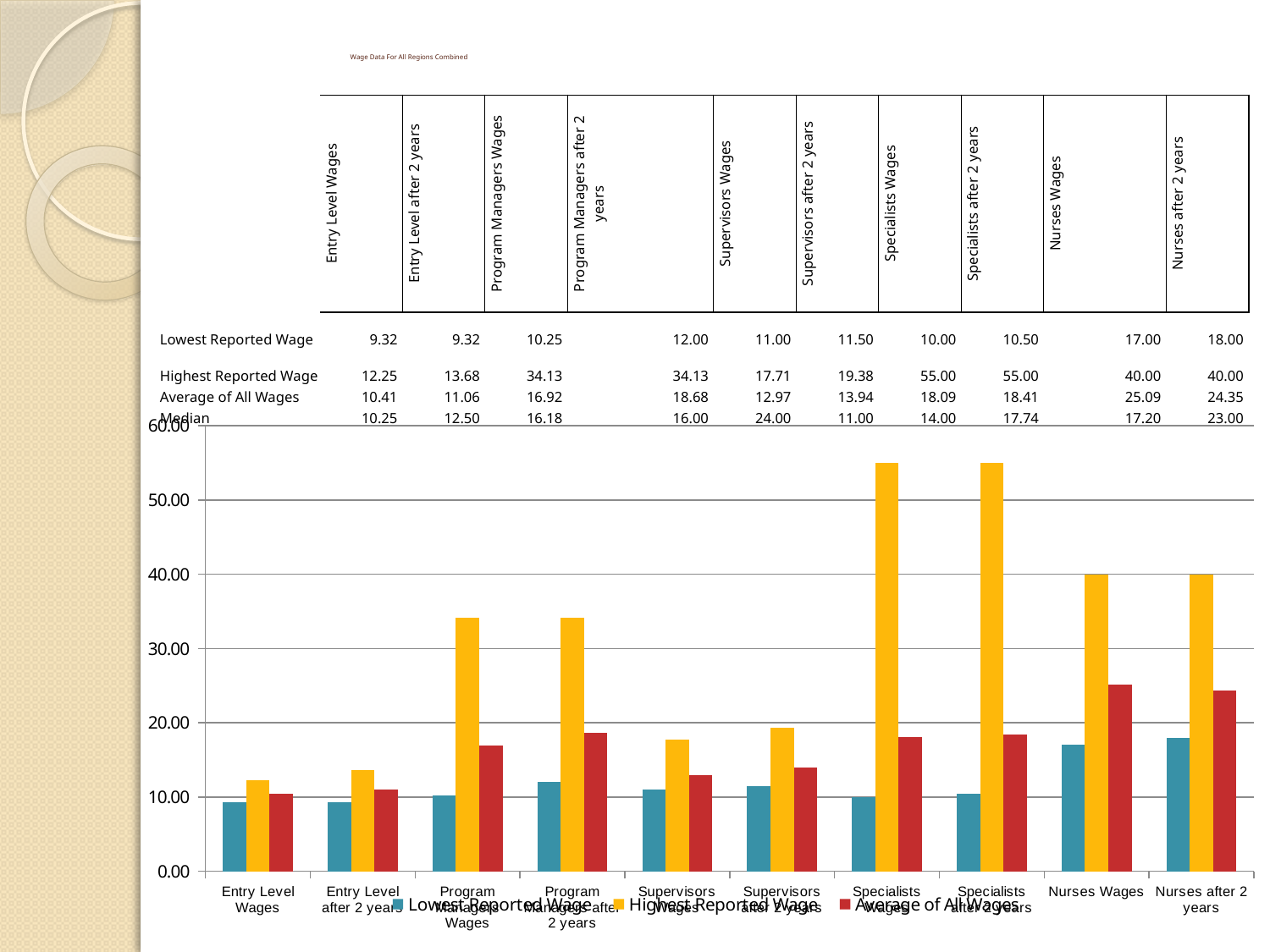
How many series does the chart legend list? 3 How many categories are shown on the x axis of the chart? 10 Which series is shown in yellow in the chart? Highest Reported Wage Is the Highest Reported Wage for Specialists after 2 years greater or less than 50.00? greater Which is larger, the Highest Reported Wage for Program Managers Wages or for Supervisors Wages? Program Managers Wages What is the difference between the Highest Reported Wage for Specialists Wages and for Nurses Wages? 15.00 What is the Highest Reported Wage for Specialists Wages? 55.00 What is the Average of All Wages for Nurses Wages? 25.09 What kind of chart is shown on the slide? bar chart Which category has the highest Lowest Reported Wage? Nurses after 2 years Which category has the highest Average of All Wages? Nurses Wages What is the Lowest Reported Wage for Program Managers after 2 years? 12.00